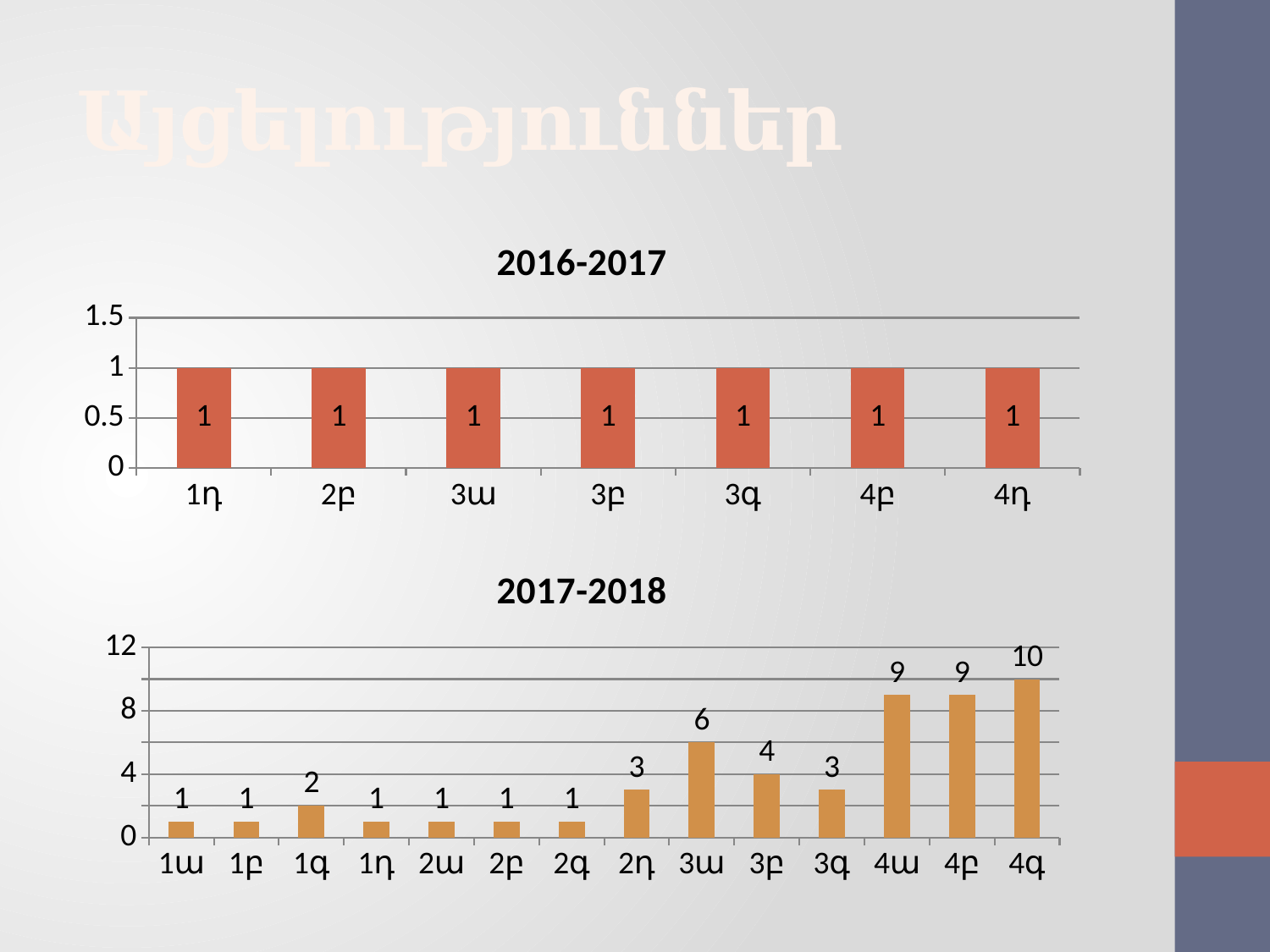
In the 2016-2017 chart, what is the value for 3գ? 1 In the 2017-2018 chart, what is the difference between the values for 4գ and 3ա? 4 In the 2017-2018 chart, which is larger, the value for 3բ or the value for 3գ? 3բ What kind of chart is the 2016-2017 chart? Bar chart In the 2017-2018 chart, what is the total of the values for 4ա, 4բ and 4գ? 28 In the 2017-2018 chart, what is the value for 4գ? 10 In the 2017-2018 chart, is the value for 4ա greater or less than 8? greater In the 2017-2018 chart, how many categories are shown on the x axis? 14 In the 2016-2017 chart, how many bars are shown? 7 In the 2017-2018 chart, what is the value for 2դ? 3 In the 2017-2018 chart, what is the value for 3ա? 6 In the 2017-2018 chart, which category has the highest value? 4գ